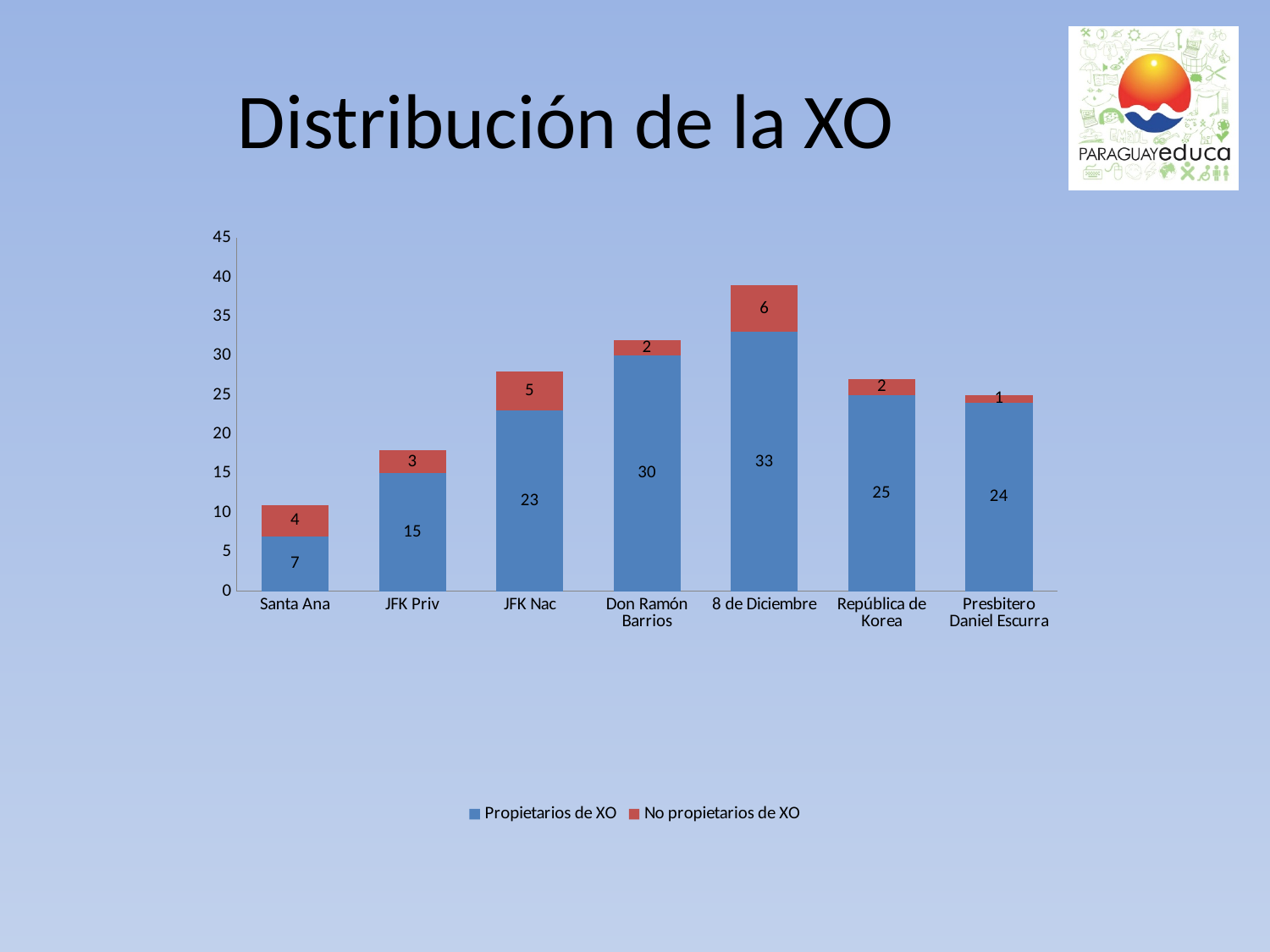
What is the difference between the Propietarios de XO values for Don Ramón Barrios and JFK Nac? 7 What is the value of Propietarios de XO for República de Korea? 25 Which category has the lowest value for No propietarios de XO? Presbitero Daniel Escurra Which category has the highest value for Propietarios de XO? 8 de Diciembre What kind of chart is shown on the slide? Stacked bar chart What is the total of the stacked bar for 8 de Diciembre? 39 How many series does the legend list? 2 How many categories are shown on the x axis? 7 What is the value of Propietarios de XO for Santa Ana? 7 What is the total of the stacked bar for Santa Ana? 11 What is the value of No propietarios de XO for 8 de Diciembre? 6 Which is larger, the Propietarios de XO value for JFK Priv or for Presbitero Daniel Escurra? Presbitero Daniel Escurra